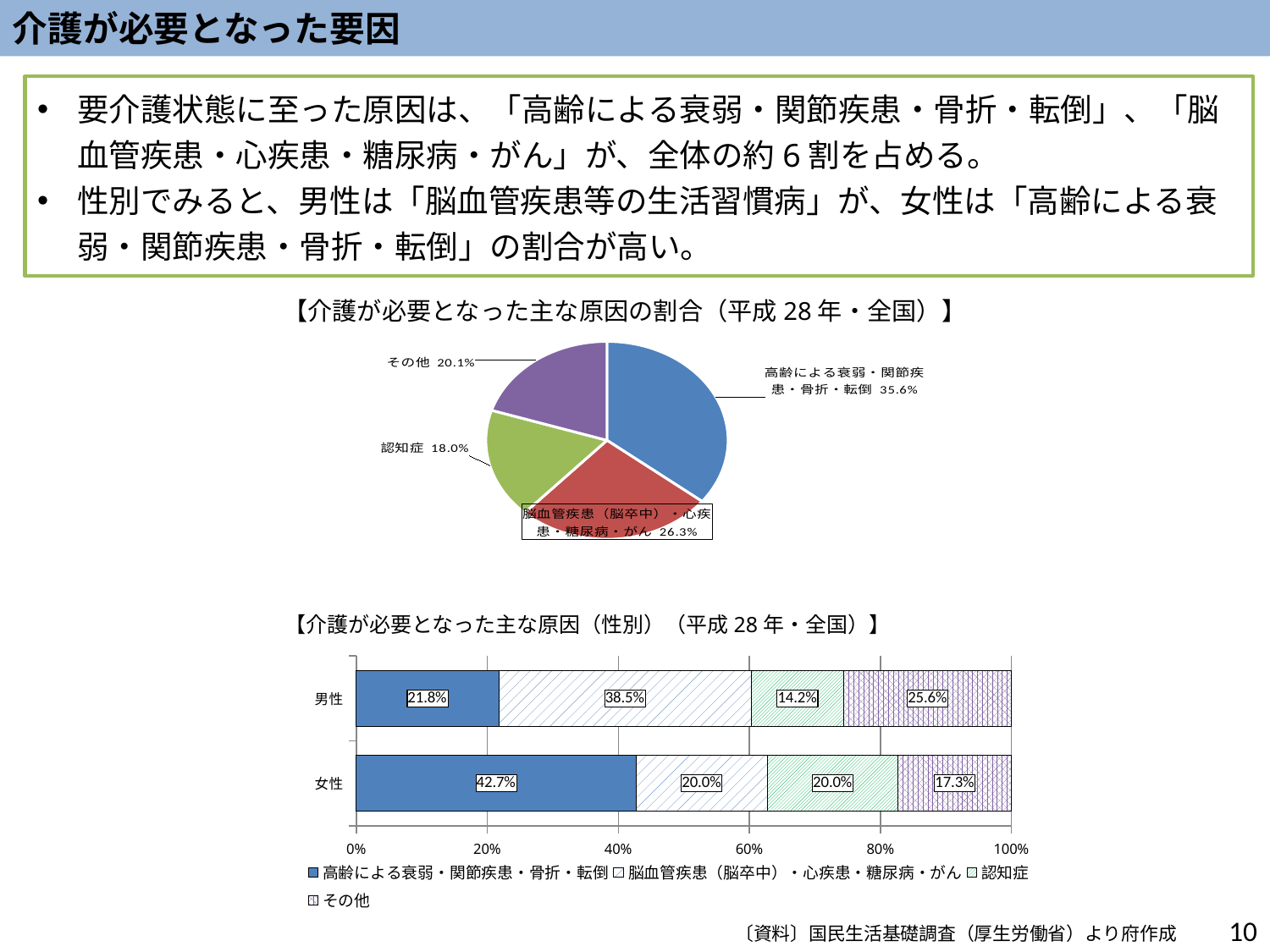
In the lower chart 【介護が必要となった主な原因（性別）（平成28年・全国）】, which is larger: the その他 value for 男性 or for 女性? 男性 In the pie chart 【介護が必要となった主な原因の割合（平成28年・全国）】, which category has the smallest share? 認知症 In the lower chart 【介護が必要となった主な原因（性別）（平成28年・全国）】, how many series does the legend list? 4 In the pie chart 【介護が必要となった主な原因の割合（平成28年・全国）】, what is the share for 高齢による衰弱・関節疾患・骨折・転倒? 35.6% In the pie chart 【介護が必要となった主な原因の割合（平成28年・全国）】, which category has the largest share? 高齢による衰弱・関節疾患・骨折・転倒 In the pie chart 【介護が必要となった主な原因の割合（平成28年・全国）】, what is the difference between the share for 脳血管疾患（脳卒中）・心疾患・糖尿病・がん and the share for その他? 6.2% In the pie chart 【介護が必要となった主な原因の割合（平成28年・全国）】, how many slices are there? 4 In the pie chart 【介護が必要となった主な原因の割合（平成28年・全国）】, what is the share for 認知症? 18.0% In the lower chart 【介護が必要となった主な原因（性別）（平成28年・全国）】, what is the value for 高齢による衰弱・関節疾患・骨折・転倒 for 女性? 42.7% In the lower chart 【介護が必要となった主な原因（性別）（平成28年・全国）】, what is the value for 脳血管疾患（脳卒中）・心疾患・糖尿病・がん for 男性? 38.5% What kind of chart is the lower chart 【介護が必要となった主な原因（性別）（平成28年・全国）】? Stacked bar chart In the lower chart 【介護が必要となった主な原因（性別）（平成28年・全国）】, what is the difference between the 認知症 value for 女性 and for 男性? 5.8%